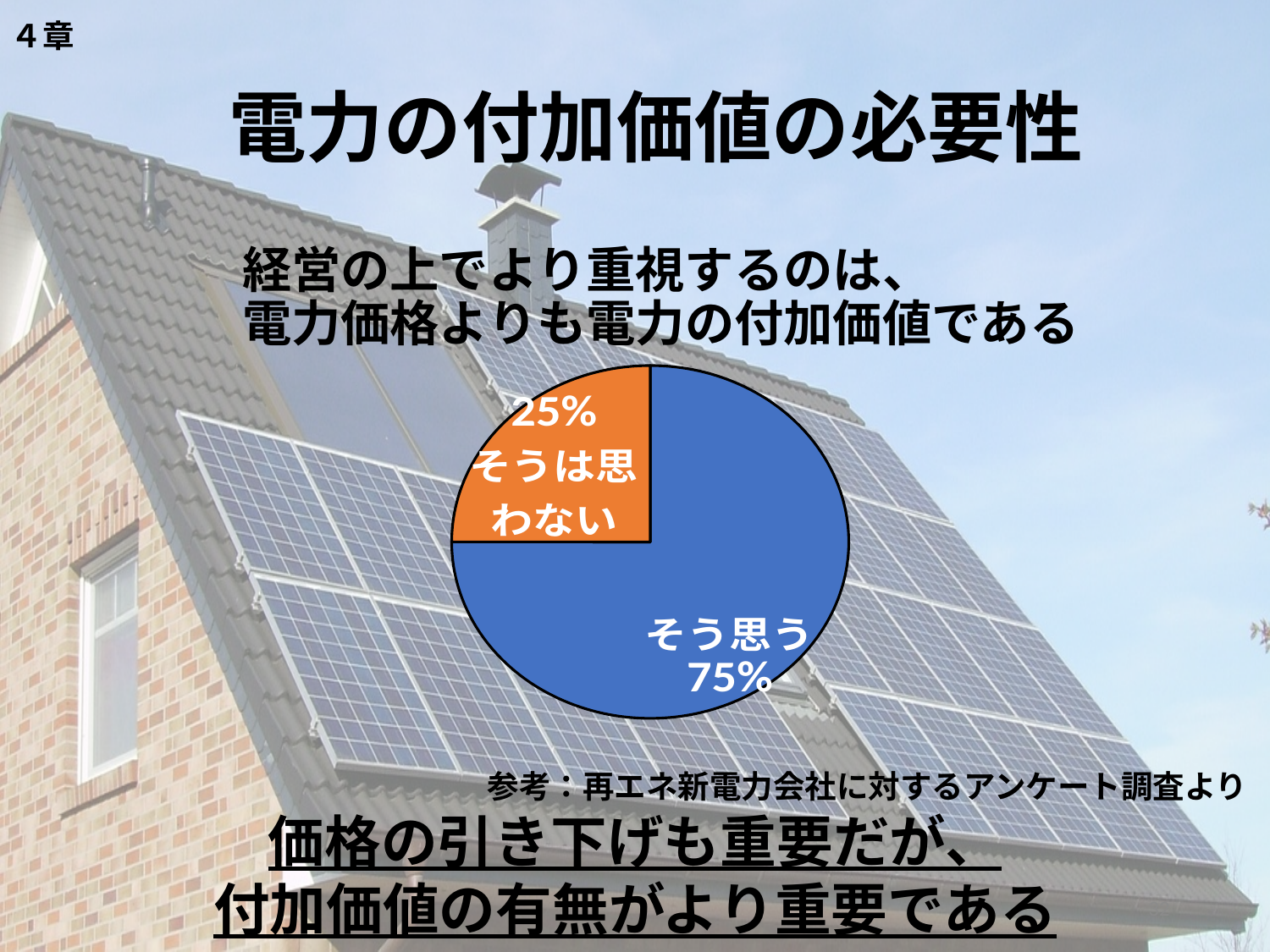
Which slice of the pie chart is the largest? そう思う What percentage of the pie chart is labelled そう思う? 75% What colour is the そう思う slice of the pie chart? blue Which slice is larger, そう思う or そうは思わない? そう思う What kind of chart is shown on the slide? pie chart How many slices does the pie chart have? 2 Is the そう思う slice greater or less than 50% of the pie? greater What share of the pie does the そう思う slice represent? 75% What is the difference in percentage points between the そう思う slice and the そうは思わない slice? 50 What colour is the そうは思わない slice of the pie chart? orange What percentage of the pie chart is labelled そうは思わない? 25% Which slice of the pie chart is the smallest? そうは思わない